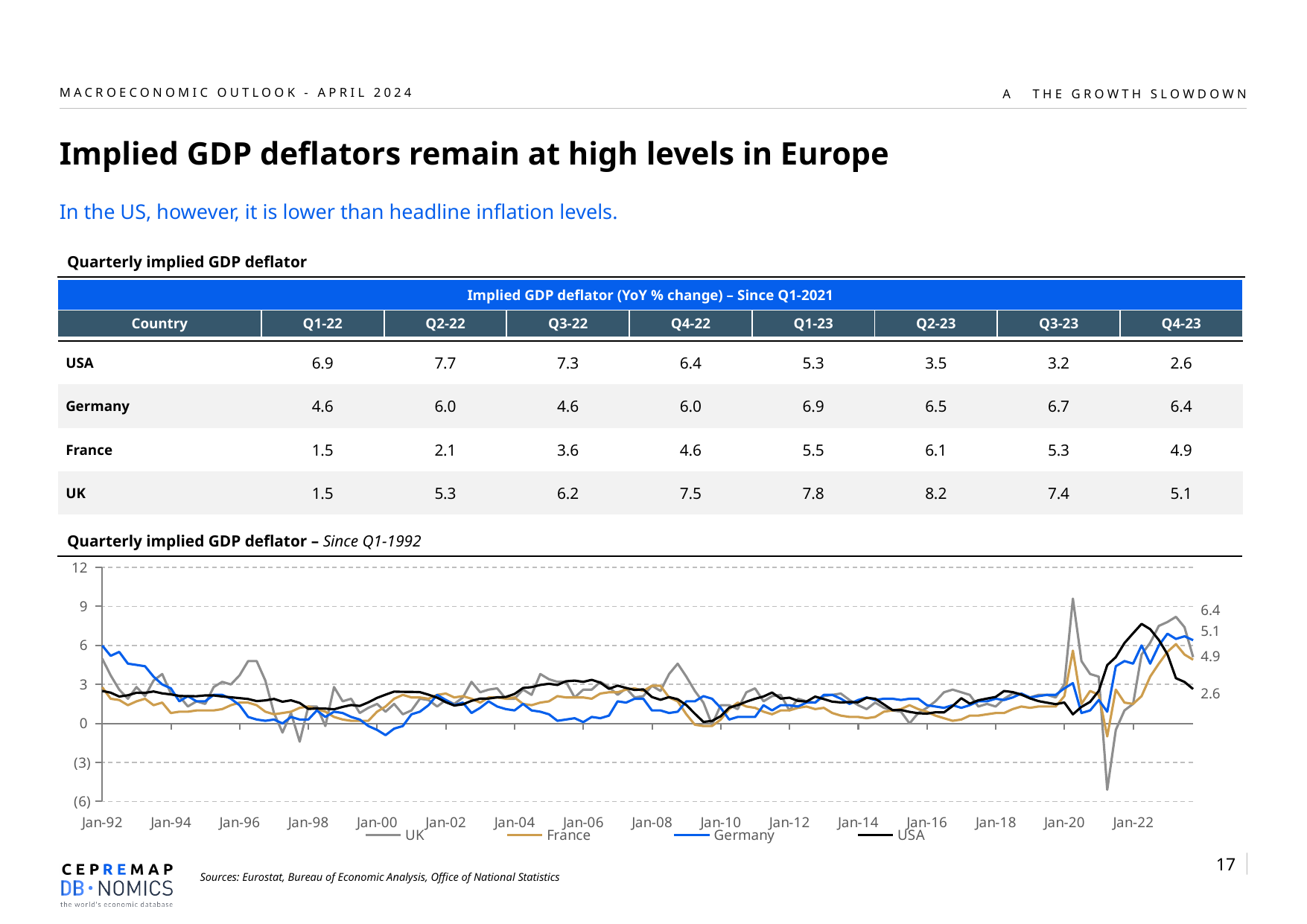
In the line chart, what is the latest value labelled for the UK? 5.1 What is the highest value shown on the y-axis of the line chart? 12 How many series does the legend of the line chart list? 4 In the line chart, what is the latest value labelled for France? 4.9 In the line chart, which country has the lowest value at the end of the series? USA In the line chart, what is the latest value labelled for Germany? 6.4 In the line chart, is the lowest point of the UK line (around 2020) greater or less than 0? less Which countries are listed in the legend of the line chart? UK, France, Germany, USA In the line chart, what is the latest value labelled for the USA? 2.6 In the line chart, which country has the highest value at the end of the series? Germany In the line chart, what is the difference between the final labelled values for Germany and the USA? 3.8 What kind of chart is the 'Quarterly implied GDP deflator – Since Q1-1992' chart? Line chart